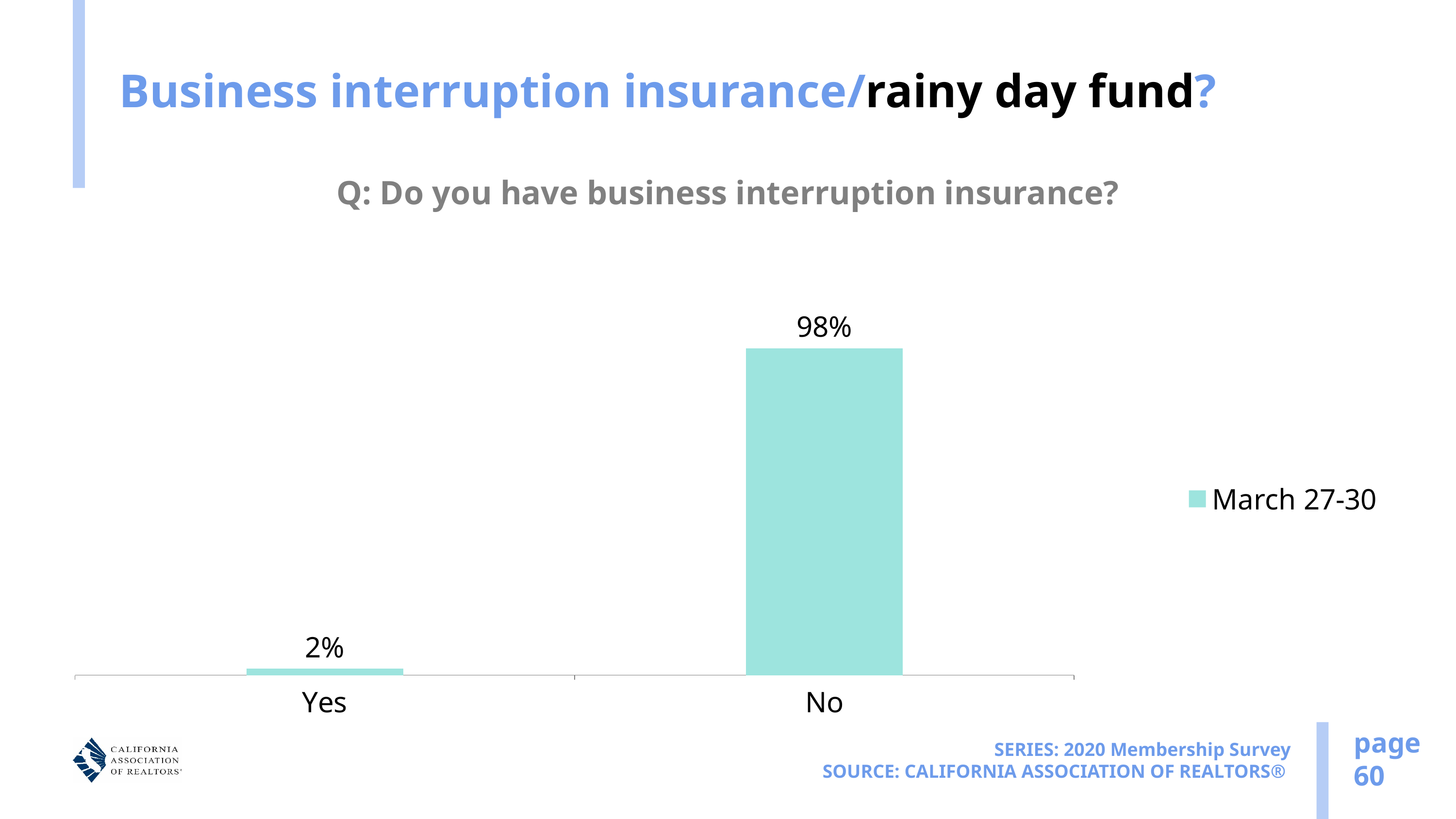
What percentage of respondents answered "Yes" to having business interruption insurance? 2% Which response category has the lowest value? Yes What kind of chart is shown on the slide? Bar chart What percentage of respondents answered "No" to having business interruption insurance? 98% How many response categories are shown on the x axis? 2 Which response category has the highest value? No Which is larger, the value for "Yes" or the value for "No"? No What is the difference between the "No" and "Yes" percentages? 96% How many series does the legend list? 1 What series name is shown in the legend? March 27-30 What is the total of the "Yes" and "No" percentages? 100% What survey question is the chart titled with? Q: Do you have business interruption insurance?